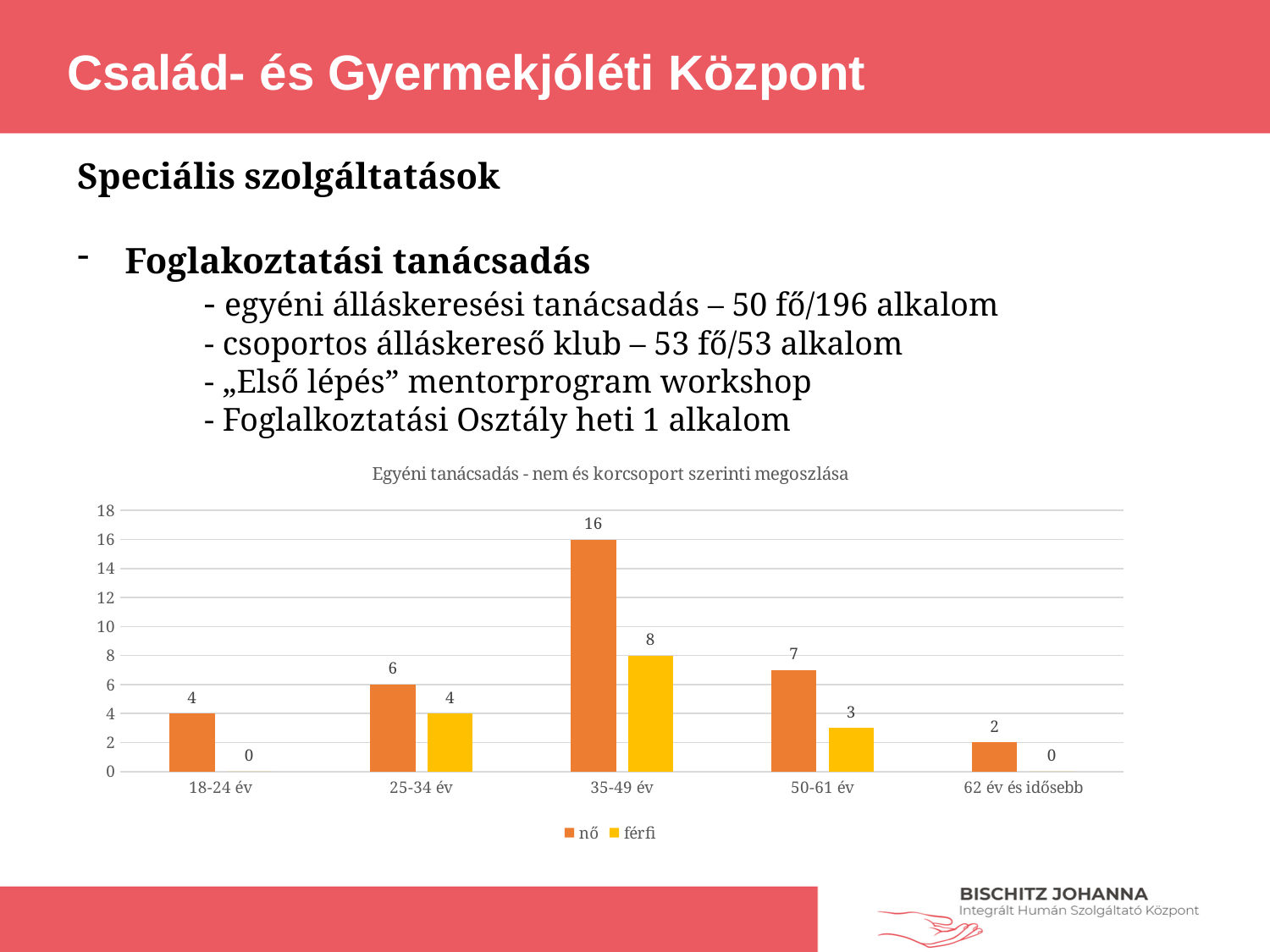
Which age category has the lowest value for nő? 62 év és idősebb Which is larger in the 25-34 év category, nő or férfi? nő What is the value for nő in the 35-49 év category? 16 Which age category has the highest value for nő? 35-49 év What is the title of the chart? Egyéni tanácsadás - nem és korcsoport szerinti megoszlása How many series does the legend list? 2 What is the difference between nő and férfi in the 35-49 év category? 8 What is the value for férfi in the 18-24 év category? 0 What is the total of nő and férfi in the 50-61 év category? 10 What kind of chart is shown on the slide? bar chart How many age categories are shown on the x axis? 5 What is the value for férfi in the 50-61 év category? 3